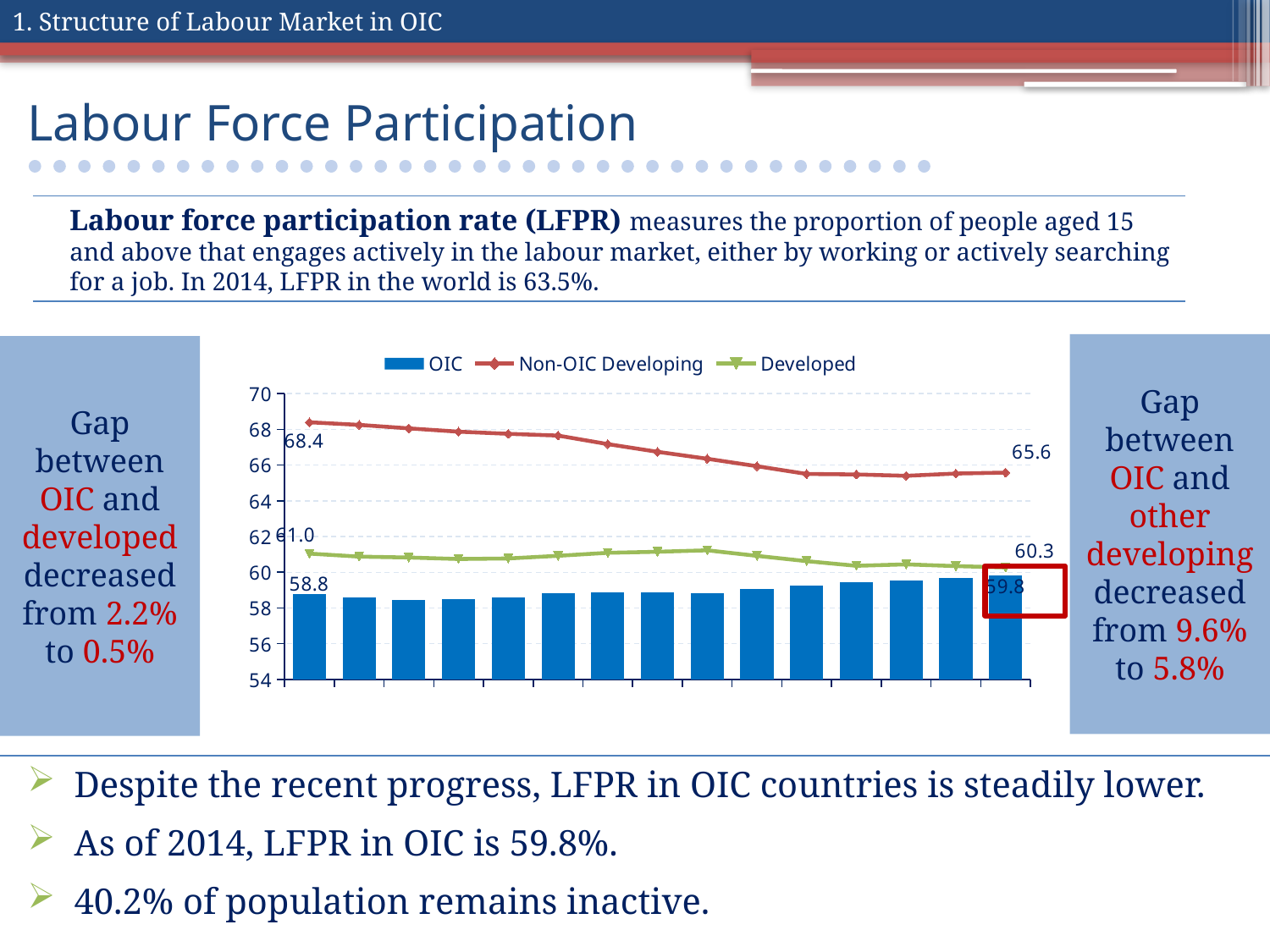
What is the last labelled value of the OIC bars? 59.8 What is the difference between the last labelled Non-OIC Developing value (65.6) and the last labelled Developed value (60.3)? 5.3 Which series is drawn as blue bars in the chart? OIC What is the first labelled value of the OIC bars? 58.8 What is the last labelled value of the Developed series? 60.3 By how much did the Non-OIC Developing series fall from its first labelled value (68.4) to its last (65.6)? 2.8 How many series does the chart legend list? 3 What kind of chart is shown on the slide? Combined bar and line chart What is the last labelled value of the Non-OIC Developing series? 65.6 At the right end of the chart, which is larger: the Non-OIC Developing value or the Developed value? Non-OIC Developing Does the Non-OIC Developing line rise or fall along the x axis? Fall What is the first labelled value of the Non-OIC Developing series? 68.4